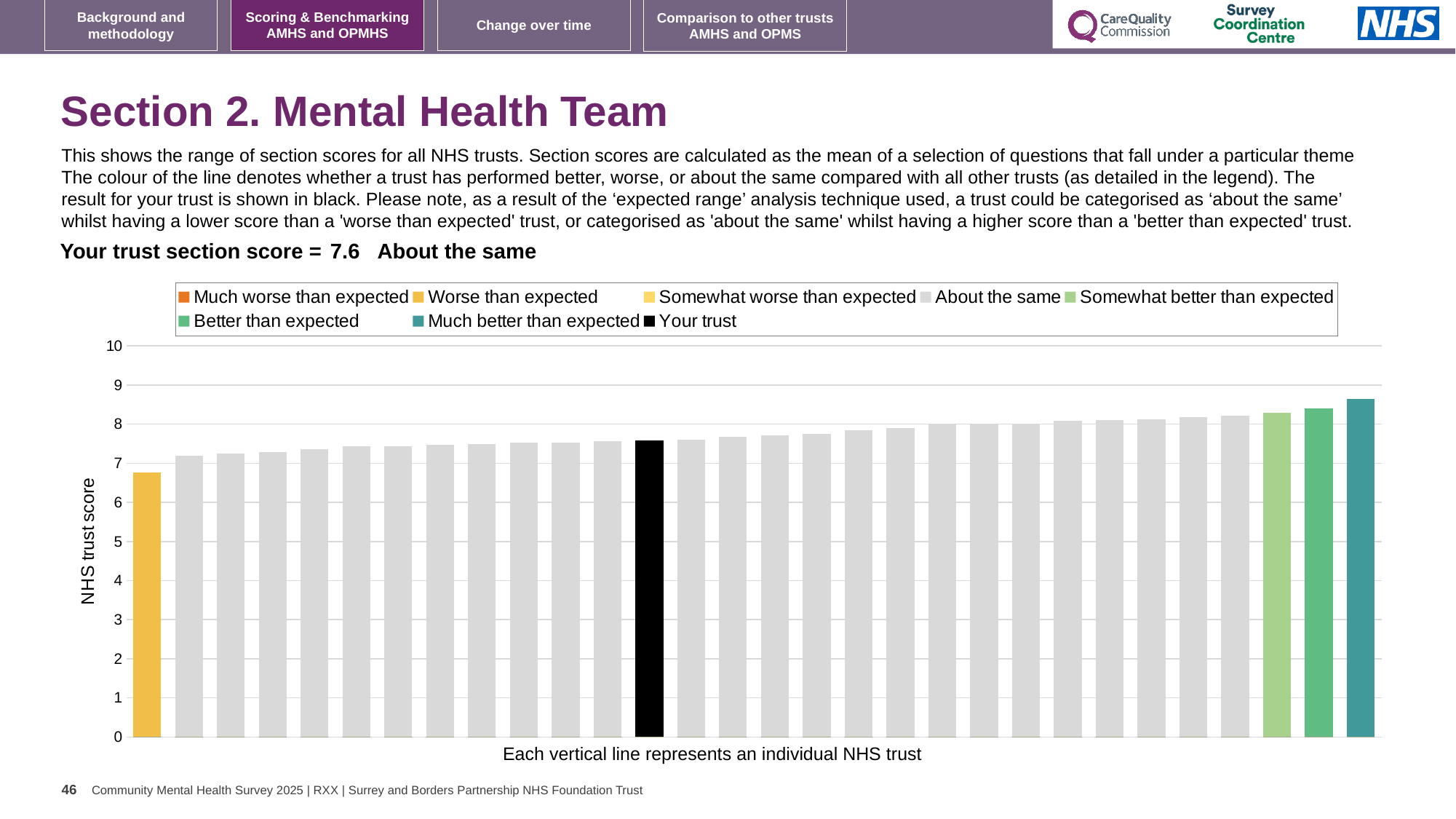
What kind of chart is shown on the slide? bar chart Is the value of the rightmost (teal) bar greater or less than 8? greater Which legend category does the lowest bar in the chart belong to? Worse than expected How is your trust's section score categorised compared with other trusts? About the same Do the bar values rise or fall from left to right across the chart? rise How many bars in the chart are coloured as 'Worse than expected'? 1 How many entries does the chart legend list? 8 Which legend category does the highest bar in the chart belong to? Much better than expected Is the value of the leftmost (yellow) bar greater or less than 7? less Is the value of the black 'Your trust' bar greater or less than 7? greater What is the label on the vertical axis of the chart? NHS trust score What is the section score for your trust shown on the slide? 7.6